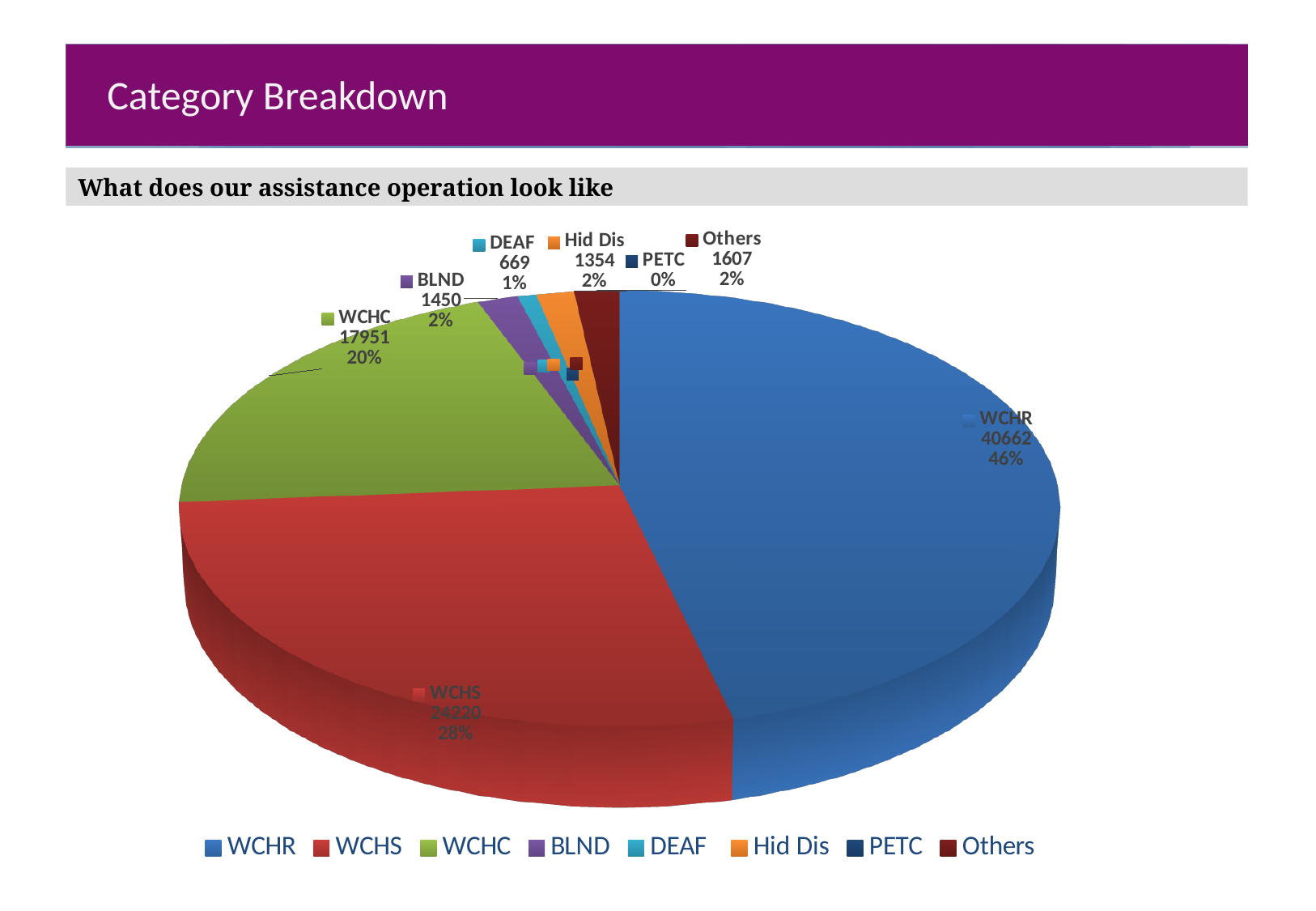
What value is shown for Hid Dis? 1354 What percentage share of the pie does WCHC have? 20% What value is shown for WCHC? 17951 What kind of chart is shown on the slide? Pie chart Which category has the smallest share of the pie? PETC Which category has the largest slice of the pie? WCHR How many categories does the legend list? 8 What is the difference between the WCHR value and the WCHS value? 16442 What colour is the WCHS slice? Red Which is larger, the value for BLND or the value for DEAF? BLND What value is shown for WCHR? 40662 What value is shown for WCHS? 24220